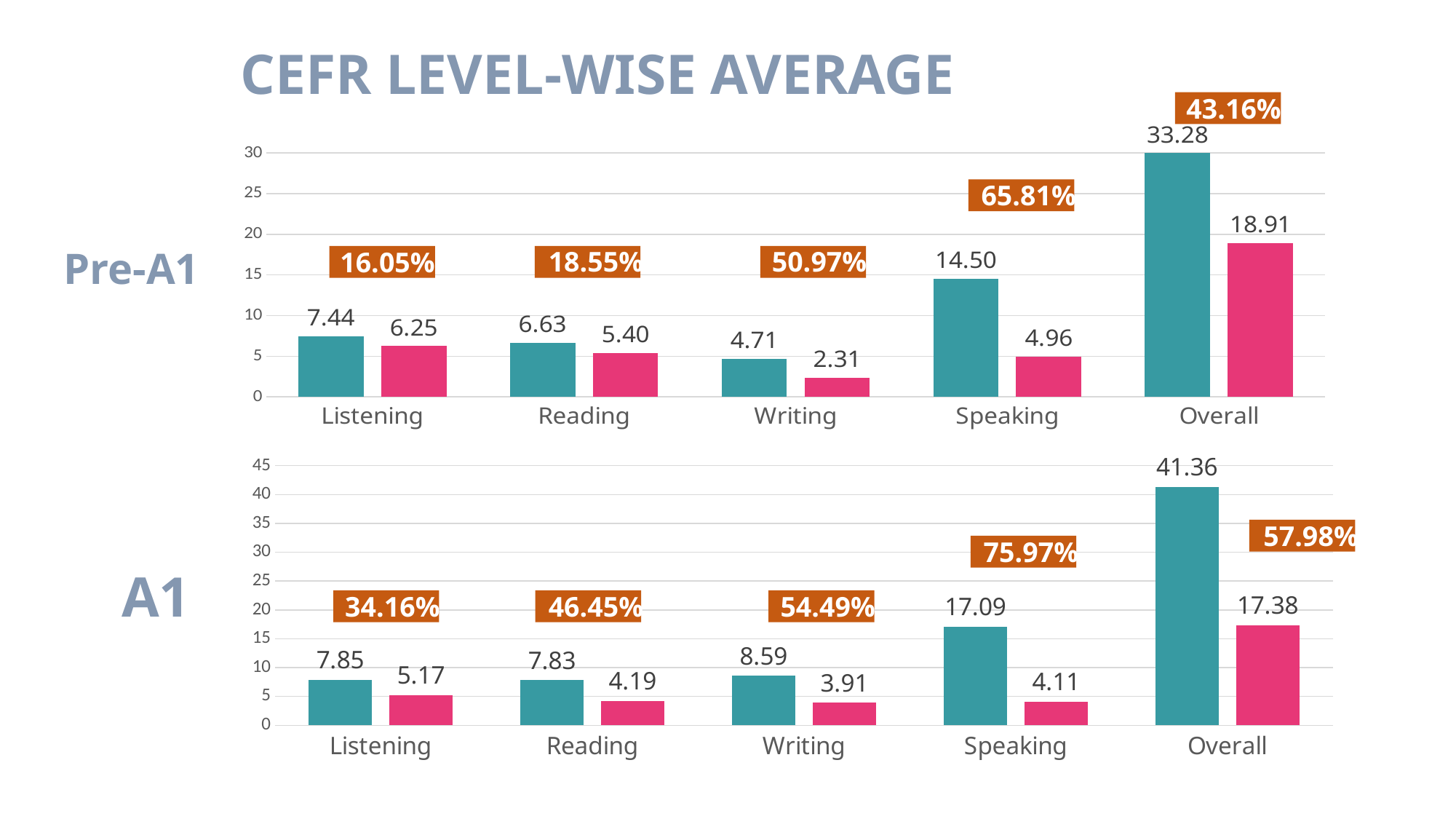
In the Pre-A1 chart, which category has the lowest pink bar? Writing In the Pre-A1 chart, what is the value of the teal bar for Speaking? 14.50 In the A1 chart, what is the value of the teal bar for Overall? 41.36 In the A1 chart, which is larger: the teal bar for Listening or the teal bar for Writing? Writing In the A1 chart, what percentage label is shown above the Speaking bars? 75.97% In the A1 chart, what is the value of the pink bar for Reading? 4.19 In the A1 chart, what is the difference between the teal and pink bars for Speaking? 12.98 How many categories are shown on the x axis of the Pre-A1 chart? 5 In the Pre-A1 chart, what is the value of the pink bar for Writing? 2.31 In the Pre-A1 chart, what is the difference between the teal and pink bars for Overall? 14.37 What type of chart is the A1 chart? Bar chart In the A1 chart, which category has the highest teal bar? Overall